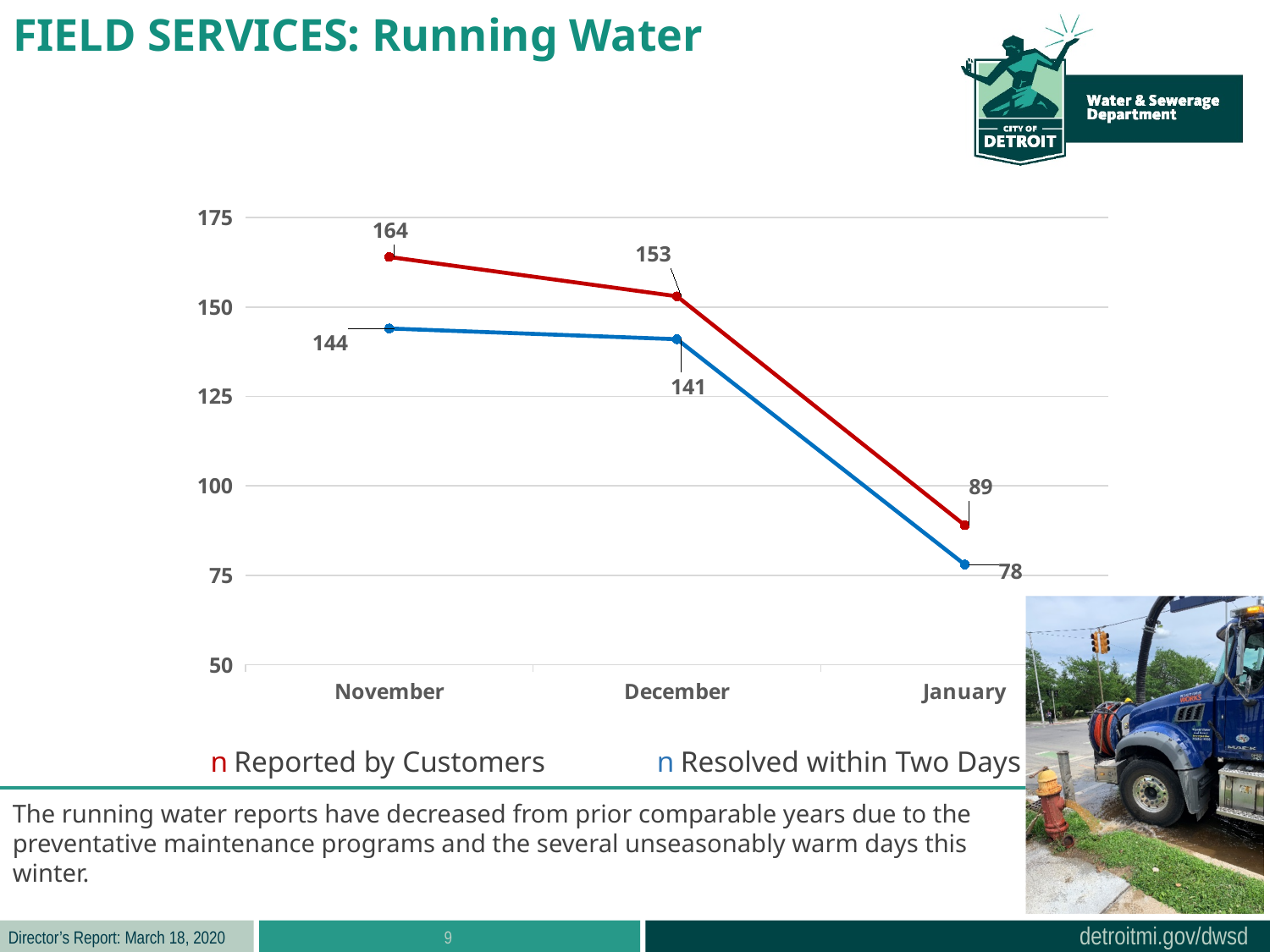
What type of chart is shown on the slide? Line chart How many series does the legend list? 2 In which month is the Resolved within Two Days value highest? November What is the value for Reported by Customers in January? 89 What colour is the line for Resolved within Two Days? Blue In which month is the Reported by Customers value lowest? January Which is larger in January: Reported by Customers or Resolved within Two Days? Reported by Customers Do the Reported by Customers values rise or fall from November to January? Fall What is the value for Reported by Customers in November? 164 How many months are plotted on the x axis? 3 What is the difference between Reported by Customers and Resolved within Two Days in December? 12 What is the value for Resolved within Two Days in December? 141